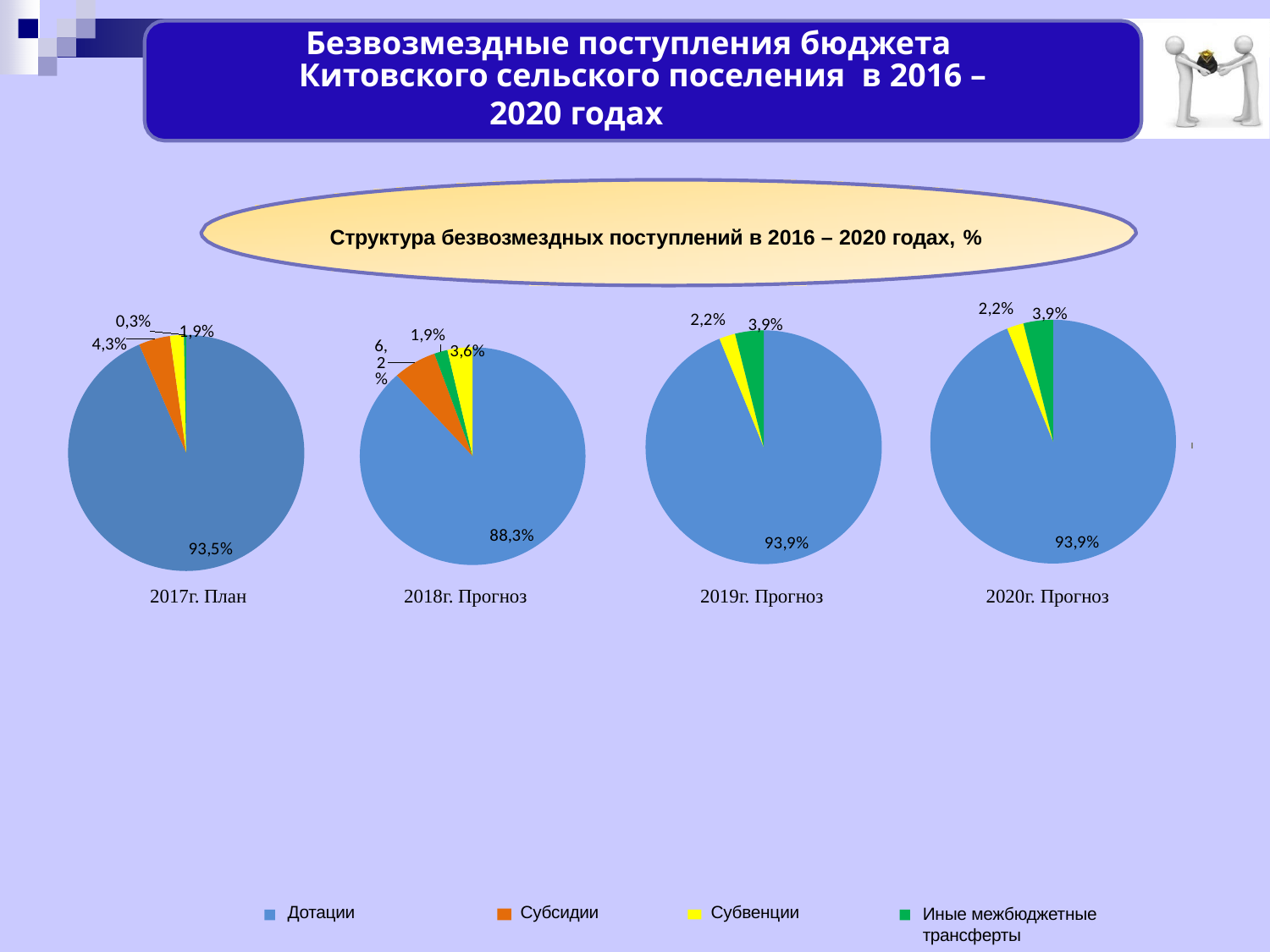
In the 2017г. План pie chart, what share is shown for Субсидии? 4,3% In the 2018г. Прогноз pie chart, what share is shown for Субсидии? 6,2% In the 2017г. План pie chart, what share is shown for Дотации? 93,5% In the 2018г. Прогноз pie chart, which category has the largest share? Дотации What is the difference between the Дотации share in the 2019г. Прогноз chart and in the 2018г. Прогноз chart? 5,6% In the 2020г. Прогноз pie chart, what share is shown for Иные межбюджетные трансферты? 3,9% In the 2019г. Прогноз pie chart, what share is shown for Субвенции? 2,2% In the 2018г. Прогноз pie chart, what share is shown for Дотации? 88,3% In the 2019г. Прогноз pie chart, what share is shown for Дотации? 93,9% Which is larger: the Дотации share in the 2017г. План chart or in the 2018г. Прогноз chart? 2017г. План How many categories does the legend list? 4 How many pie charts are shown on the slide? 4